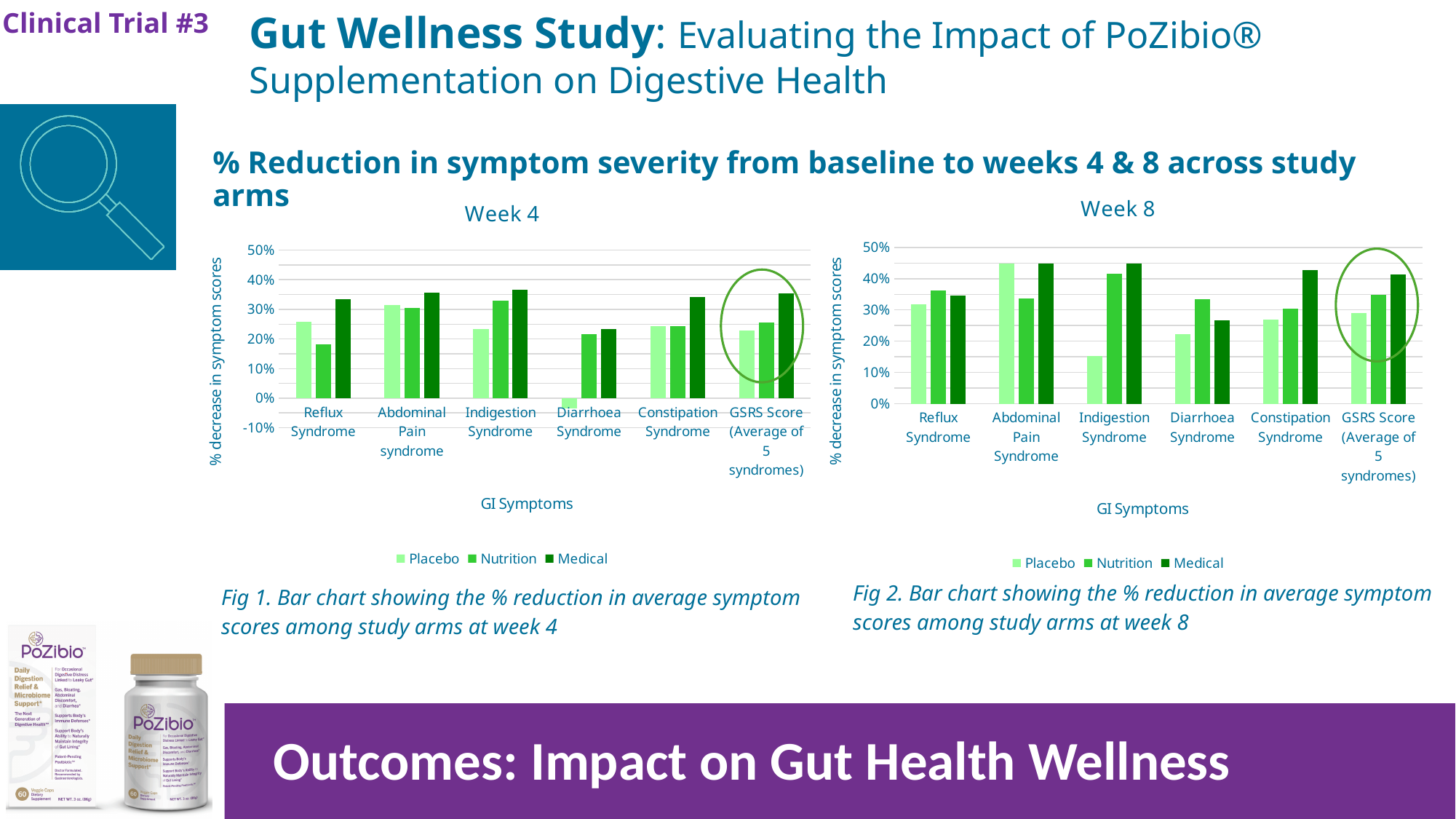
In the Week 8 chart, which is larger for Diarrhoea Syndrome: the Nutrition value or the Medical value? Nutrition How many GI symptom categories are shown on the x axis of the Week 8 chart? 6 In the Week 4 chart, is the Medical value for Reflux Syndrome greater or less than 30%? greater In the Week 8 chart, is the Placebo value for Indigestion Syndrome greater or less than 20%? less What kind of chart is the Week 4 chart? bar chart In the Week 4 chart, is the Nutrition value for Reflux Syndrome greater or less than 20%? less In the Week 8 chart, which category has the lowest Placebo value? Indigestion Syndrome In the Week 4 chart, which is larger for Constipation Syndrome: the Medical value or the Placebo value? Medical What are the legend entries of the Week 8 chart? Placebo, Nutrition, Medical How many series does the legend of the Week 4 chart list? 3 In the Week 4 chart, which category has a negative value for Placebo? Diarrhoea Syndrome